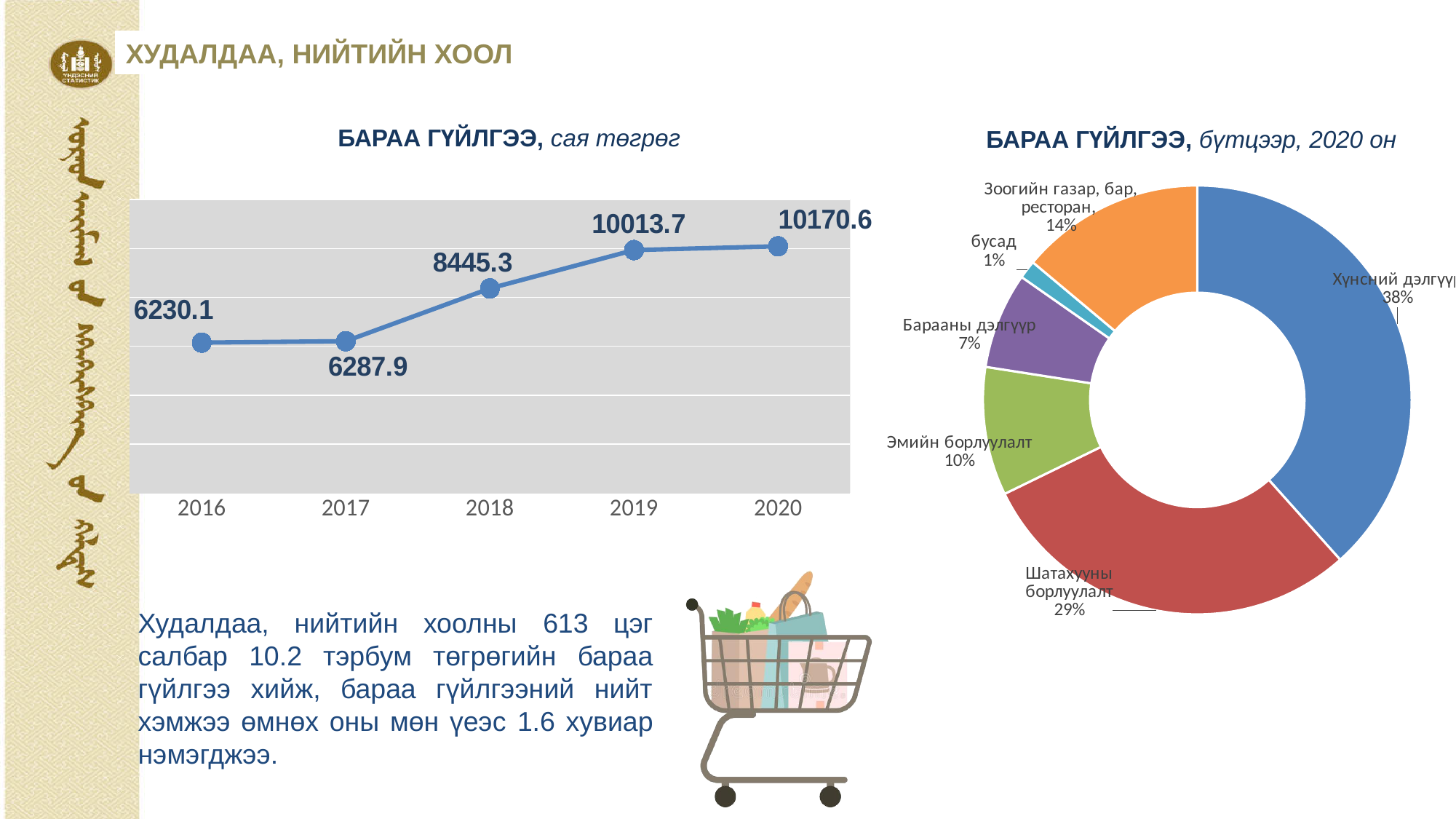
In the line chart 'БАРАА ГҮЙЛГЭЭ, сая төгрөг', which year has the lowest value? 2016 In the line chart 'БАРАА ГҮЙЛГЭЭ, сая төгрөг', how many years are plotted? 5 What type of chart is the left chart titled 'БАРАА ГҮЙЛГЭЭ, сая төгрөг'? line chart In the line chart 'БАРАА ГҮЙЛГЭЭ, сая төгрөг', do the values rise or fall from 2016 to 2020? rise In the line chart 'БАРАА ГҮЙЛГЭЭ, сая төгрөг', what is the value for 2018? 8445.3 In the line chart 'БАРАА ГҮЙЛГЭЭ, сая төгрөг', what is the value for 2020? 10170.6 In the doughnut chart 'БАРАА ГҮЙЛГЭЭ, бүтцээр, 2020 он', which is larger: 'Эмийн борлуулалт' or 'Барааны дэлгүүр'? Эмийн борлуулалт In the doughnut chart 'БАРАА ГҮЙЛГЭЭ, бүтцээр, 2020 он', how many categories are shown? 6 In the doughnut chart 'БАРАА ГҮЙЛГЭЭ, бүтцээр, 2020 он', what share does 'Шатахууны борлуулалт' have? 29% In the line chart 'БАРАА ГҮЙЛГЭЭ, сая төгрөг', what is the difference between the 2019 and 2018 values? 1568.4 In the line chart 'БАРАА ГҮЙЛГЭЭ, сая төгрөг', which year has the highest value? 2020 In the doughnut chart 'БАРАА ГҮЙЛГЭЭ, бүтцээр, 2020 он', which category has the largest share? Хүнсний дэлгүүр